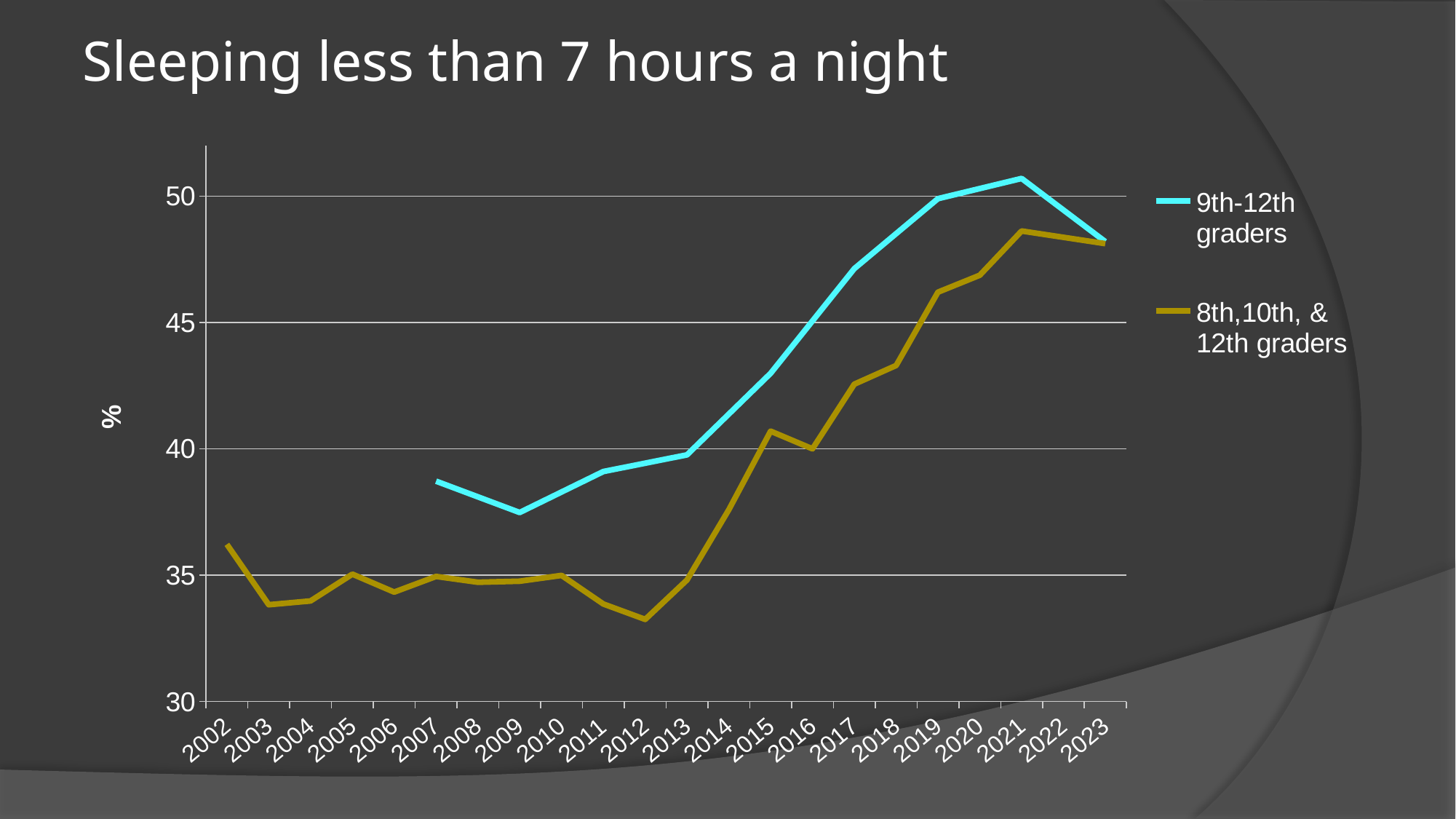
In 2015, which series has the higher value: 9th-12th graders or 8th,10th, & 12th graders? 9th-12th graders How many series does the legend list? 2 What is the label on the y axis? % What kind of chart is shown on the slide? line chart What is the title of the chart? Sleeping less than 7 hours a night Does the 9th-12th graders series rise or fall between 2013 and 2021? rise How many years are labelled along the x axis? 22 Is the value for 9th-12th graders in 2021 greater or less than 50? greater Is the value for 9th-12th graders in 2009 greater or less than 40? less Is the value for 8th,10th, & 12th graders in 2019 greater or less than 45? greater In which year does the 9th-12th graders series reach its highest value? 2021